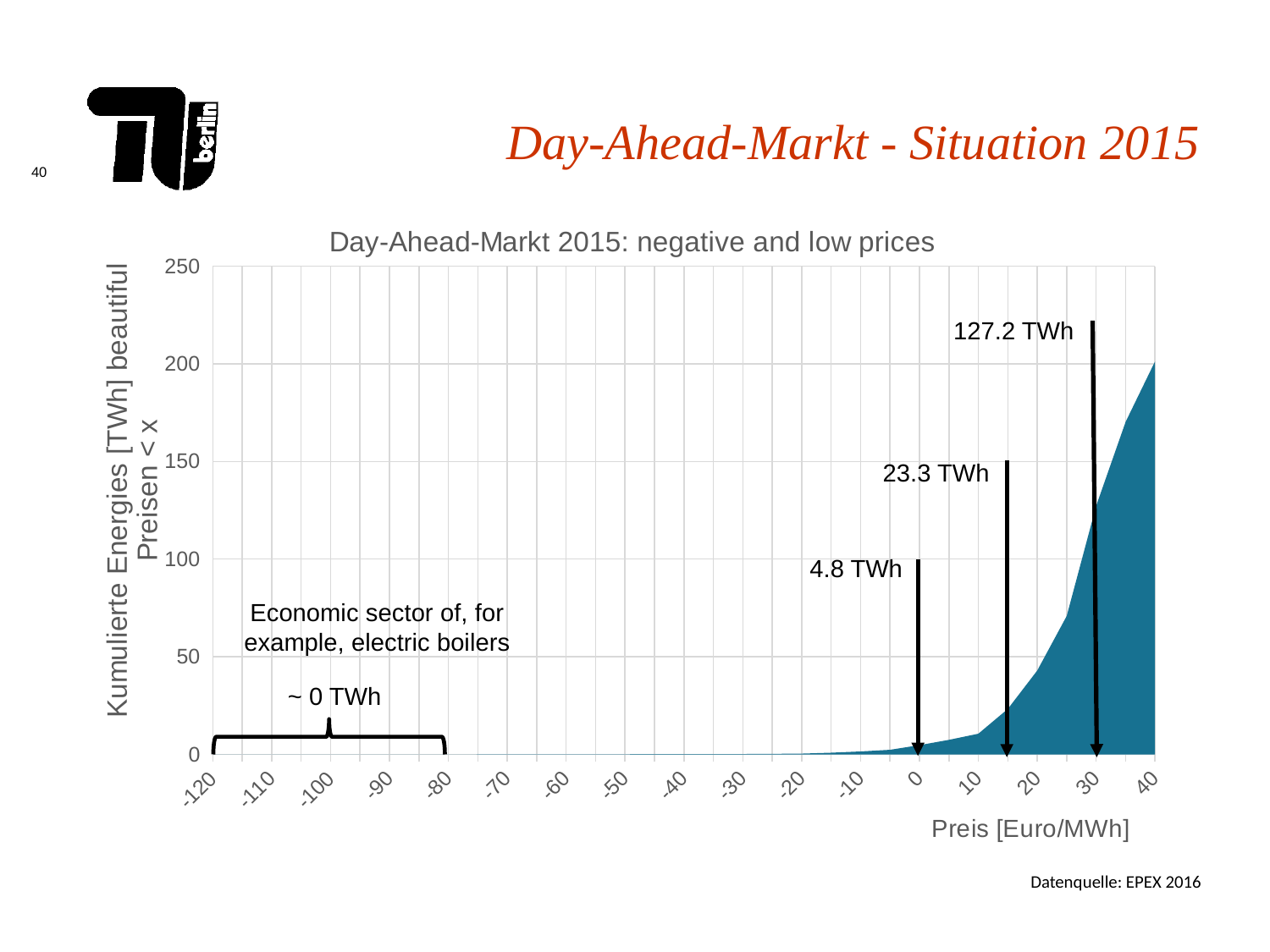
Does the cumulative energy rise or fall as the price increases along the x axis? rise What is the label of the x axis of the chart? Preis [Euro/MWh] What cumulative energy value is annotated at a price of 30 Euro/MWh? 127.2 TWh How many tick labels are shown on the x axis? 17 What cumulative energy value is annotated at a price of about 15 Euro/MWh? 23.3 TWh What kind of chart is shown on the slide? area chart Is the cumulative energy at a price of -50 Euro/MWh greater or less than 50 TWh? less What is the highest value shown on the y axis? 250 Is the cumulative energy at a price of 40 Euro/MWh greater or less than 150 TWh? greater What is the title of the chart? Day-Ahead-Markt 2015: negative and low prices What cumulative energy value is annotated for the price range from -120 to -80 Euro/MWh? ~ 0 TWh What cumulative energy value is annotated at a price of 0 Euro/MWh? 4.8 TWh